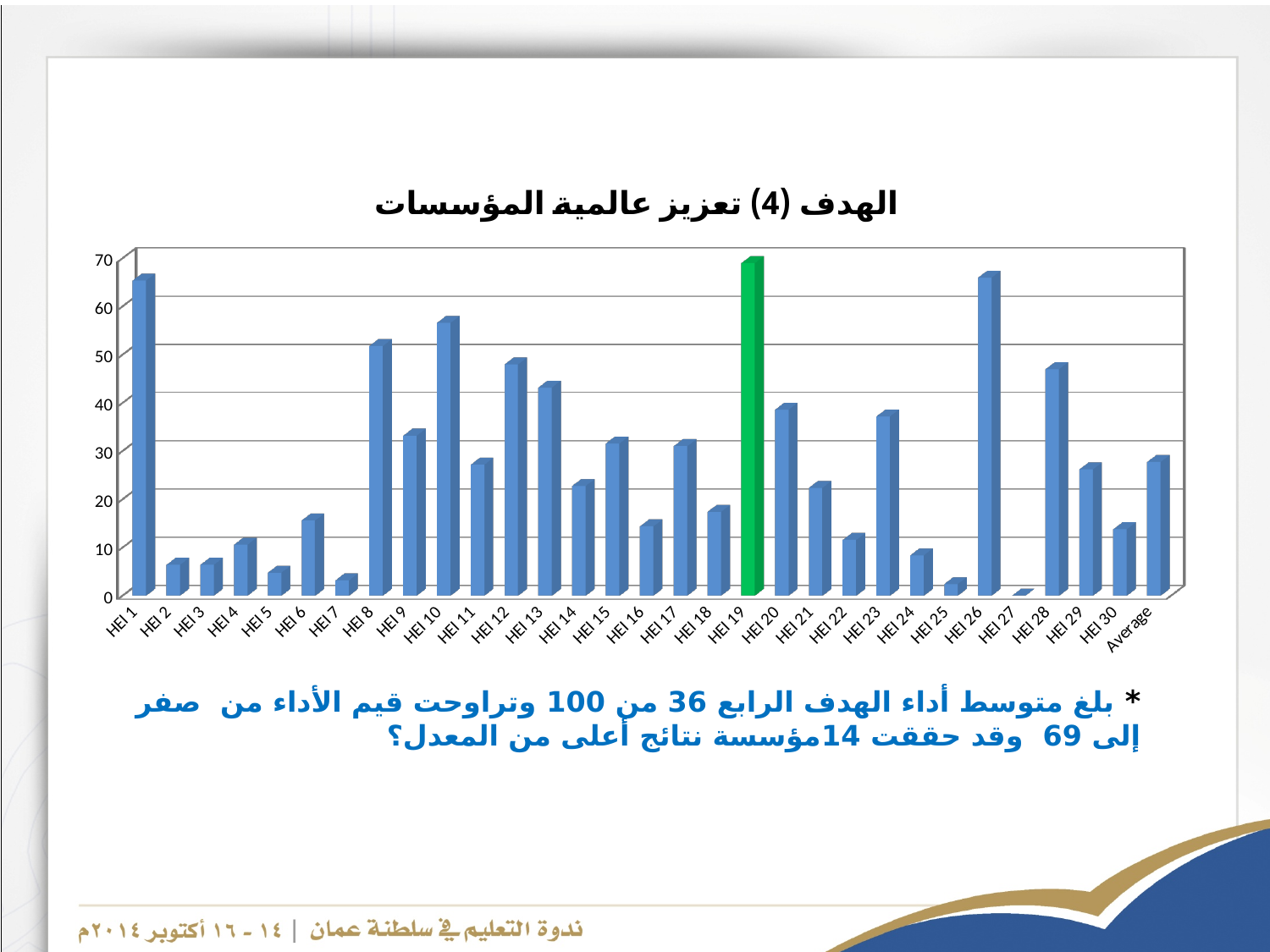
Which category has the highest bar in the chart? HEI 19 Which is larger, the value for HEI 13 or the value for HEI 14? HEI 13 Which category has the lowest bar in the chart? HEI 27 Is the value for HEI 7 greater or less than 10? less Which bar in the chart is coloured green rather than blue? HEI 19 How many categories are plotted along the x axis of the chart? 31 Is the value for HEI 1 greater or less than 60? greater What kind of chart is shown on the slide? bar chart Is the value for HEI 10 greater or less than 50? greater Which is larger, the value for HEI 10 or the value for HEI 9? HEI 10